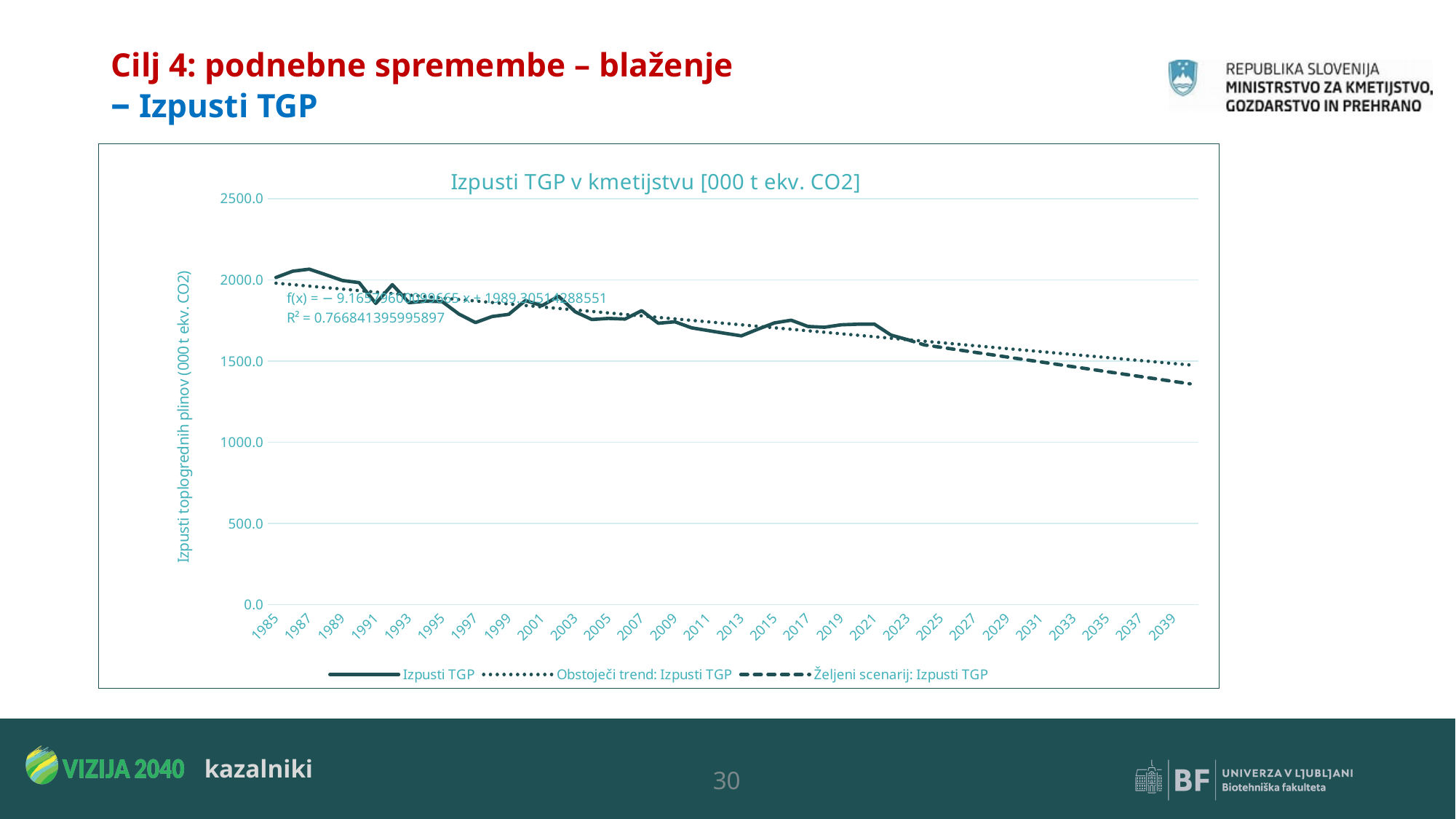
What is the title of the chart? Izpusti TGP v kmetijstvu [000 t ekv. CO2] Which is larger, the Izpusti TGP value for 1985 or for 2013? 1985 Is the Izpusti TGP value for 2013 greater or less than 2000? less Is the Izpusti TGP value for 1987 greater or less than 2000? greater Which series is drawn with a dashed line according to the legend? Željeni scenarij: Izpusti TGP How many series does the legend list? 3 What R² value is printed on the chart for the trend line? 0.766841395995897 Is the Željeni scenarij: Izpusti TGP value for 2039 greater or less than 1500? less In which year does the Izpusti TGP series reach its highest value? 1987 What kind of chart is shown on the slide? line chart Do the Izpusti TGP values generally rise or fall from 1985 to 2023? fall